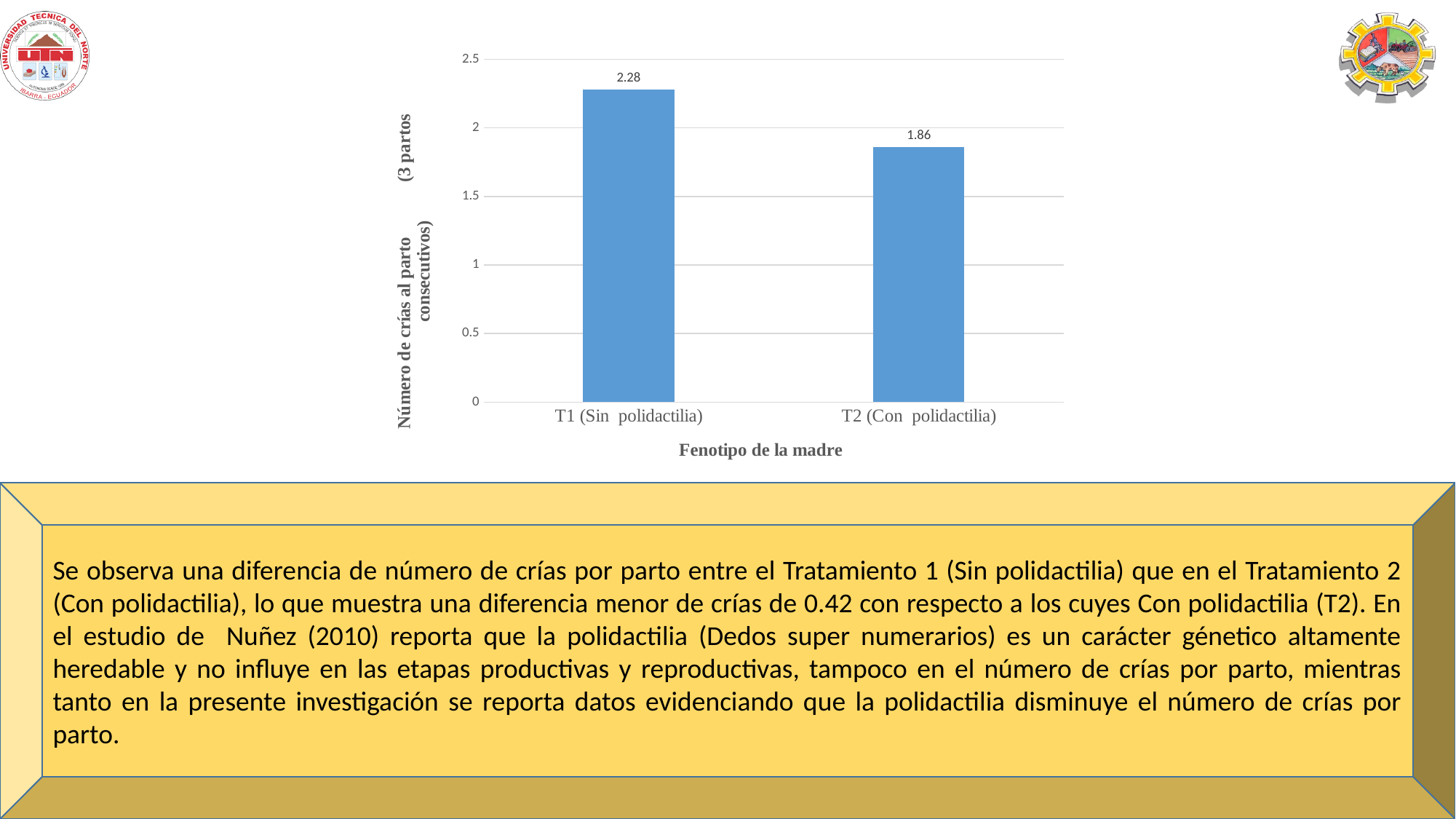
Which is larger, the value for T1 (Sin polidactilia) or T2 (Con polidactilia)? T1 (Sin polidactilia) What is the x-axis title of the chart? Fenotipo de la madre What is the value for T2 (Con polidactilia)? 1.86 Is the value for T1 (Sin polidactilia) greater or less than 2? greater Which category has the lowest value? T2 (Con polidactilia) What is the value for T1 (Sin polidactilia)? 2.28 What is the difference between the values for T1 (Sin polidactilia) and T2 (Con polidactilia)? 0.42 What is the highest tick value shown on the y axis? 2.5 What kind of chart is shown on the slide? bar chart Is the value for T2 (Con polidactilia) greater or less than 2? less How many categories are shown on the x axis? 2 Which category has the highest value? T1 (Sin polidactilia)